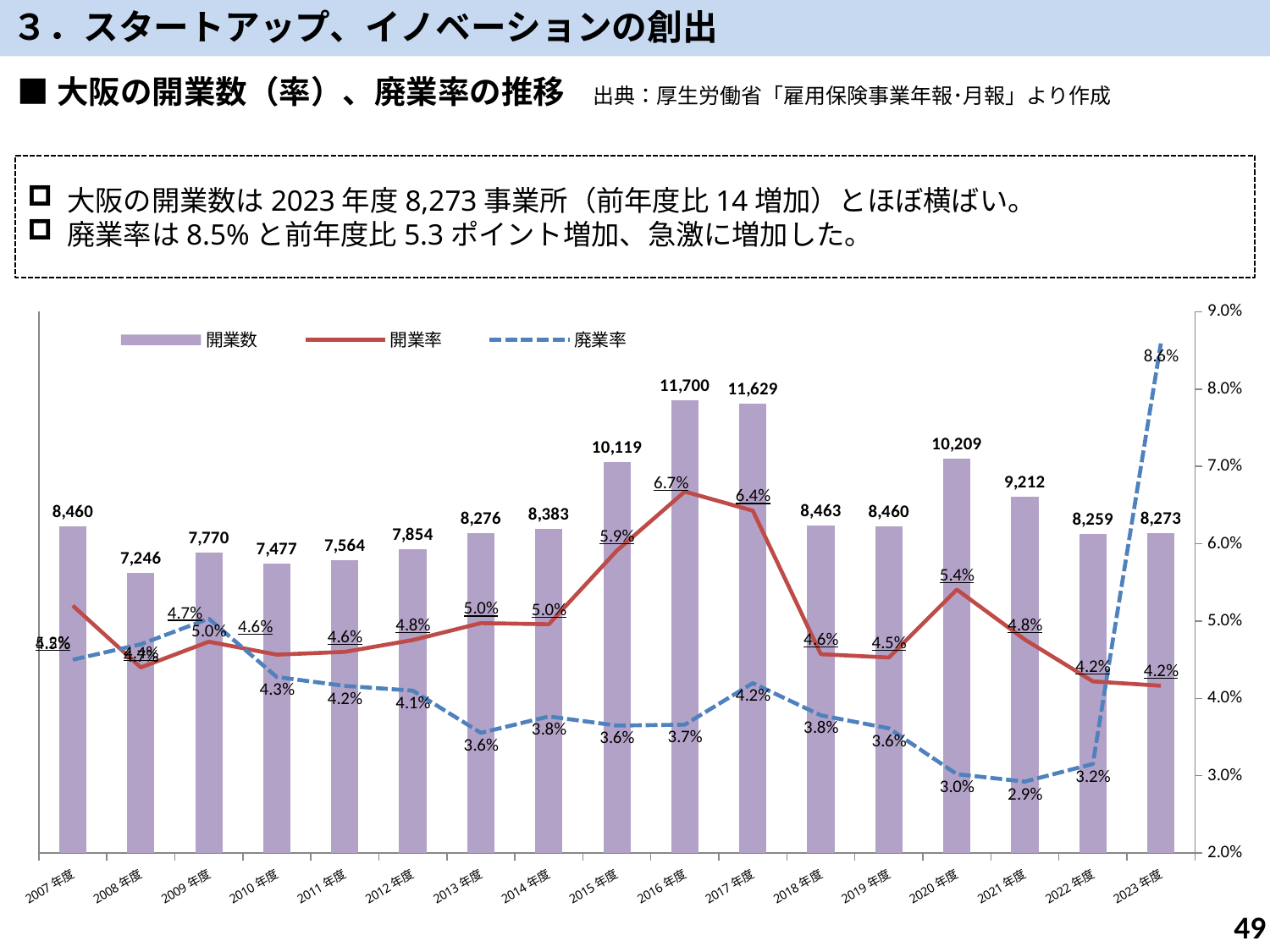
How many series does the legend list? 3 What kind of chart is this? Combined bar and line chart What is the difference in 開業数 between 2016年度 and 2017年度? 71 What is the 開業率 value for 2016年度? 6.7% What is the difference in 開業数 between 2022年度 and 2023年度? 14 What is the 開業数 value for 2023年度? 8,273 Which year has the lowest 開業数? 2008年度 What is the 廃業率 value for 2021年度? 2.9% Is the 廃業率 value for 2023年度 greater or less than 8.0%? greater Which year has the highest 開業数? 2016年度 Which is larger, the 開業数 for 2015年度 or for 2020年度? 2020年度 How many fiscal years are shown on the x axis? 17